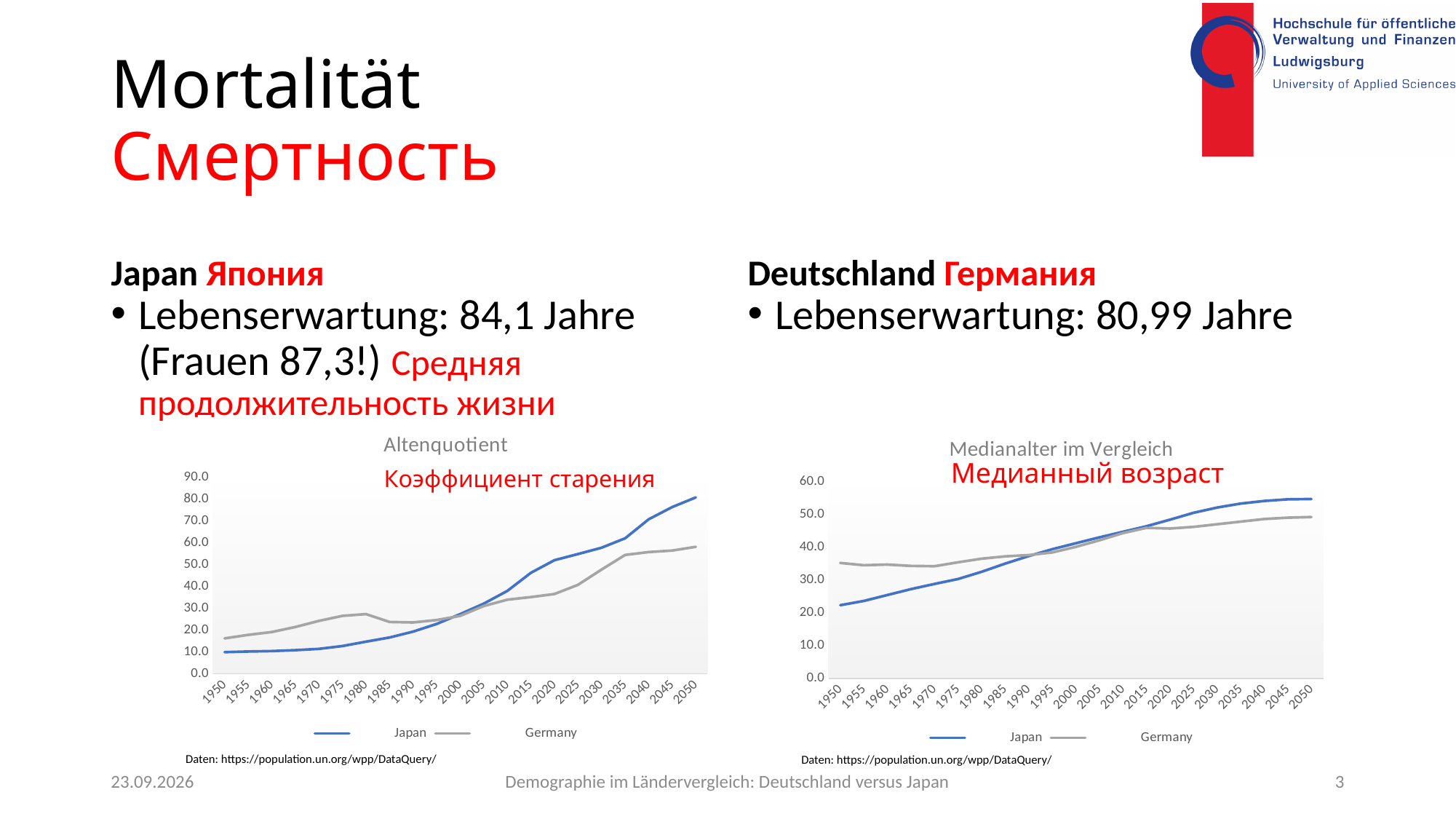
In the 'Altenquotient' chart, is the value for Japan in 2050 greater or less than 70? greater In the 'Altenquotient' chart, which series has the higher value in 1975, Japan or Germany? Germany How many series does the legend of the 'Medianalter im Vergleich' chart list? 2 In the 'Medianalter im Vergleich' chart, is the value for Germany in 1950 greater or less than 30? greater In the 'Altenquotient' chart, which series has the higher value in 2050, Japan or Germany? Japan In the 'Altenquotient' chart, is the value for Japan in 1950 greater or less than 20? less Which colour represents Germany in the legend of the 'Altenquotient' chart? grey What kind of chart is the 'Altenquotient' chart on the left? line chart In the 'Medianalter im Vergleich' chart, which series has the higher value in 2050, Japan or Germany? Japan In the 'Altenquotient' chart, how many years are labelled on the x axis? 21 In the 'Medianalter im Vergleich' chart, does the Japan series rise or fall from 1950 to 2050? rise